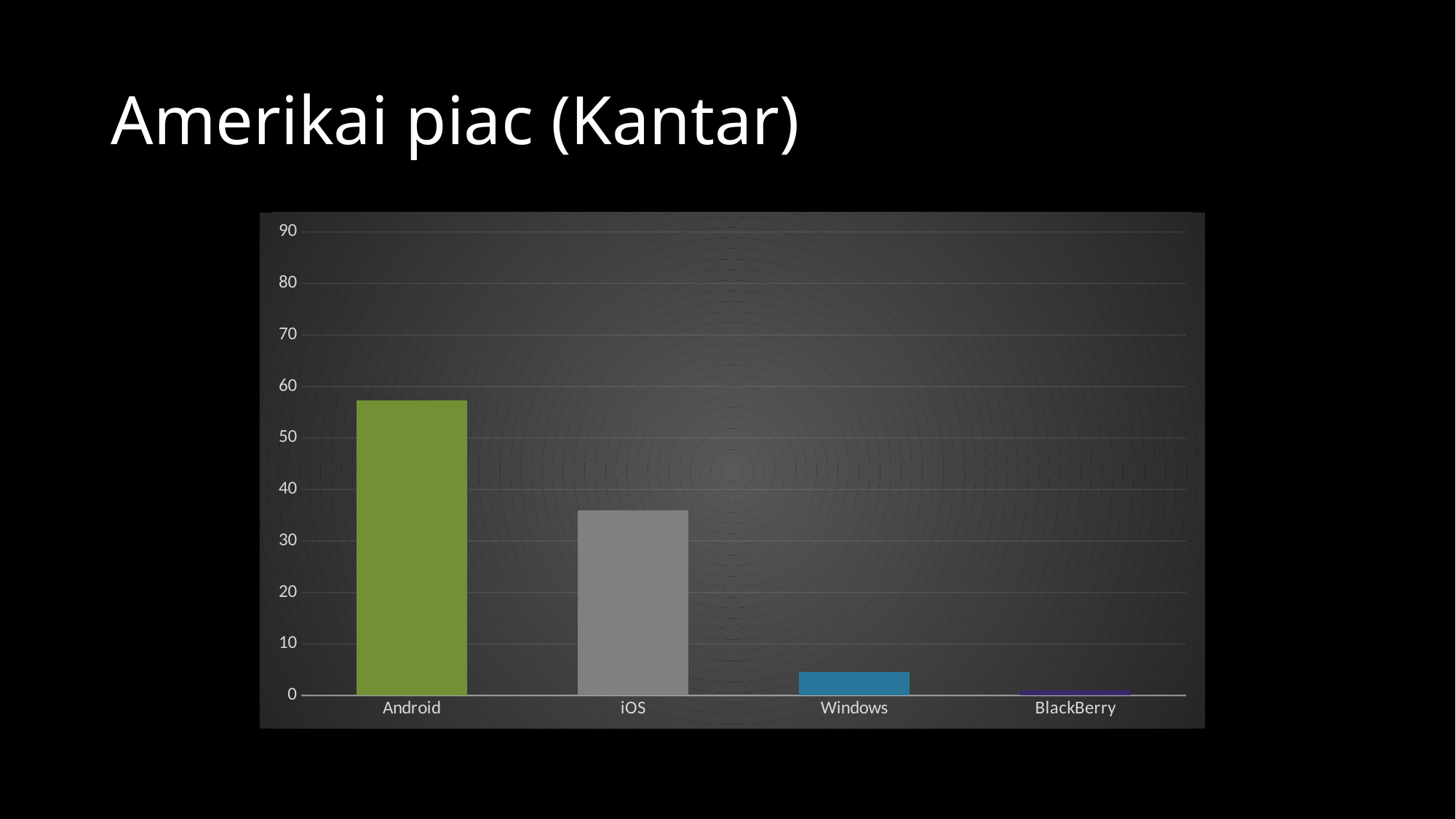
What is the title of the slide containing the chart? Amerikai piac (Kantar) Which is larger, the value for Android or the value for iOS? Android Is the value for Android greater or less than 50? greater Which category has the highest bar in the chart? Android How many categories are shown on the x axis of the chart? 4 What kind of chart is shown on the slide? bar chart Is the value for Windows greater or less than 10? less Is the value for iOS greater or less than 40? less Which is larger, the value for Windows or the value for BlackBerry? Windows Which category has the lowest bar in the chart? BlackBerry Do the bar values rise or fall from left to right along the x axis? fall